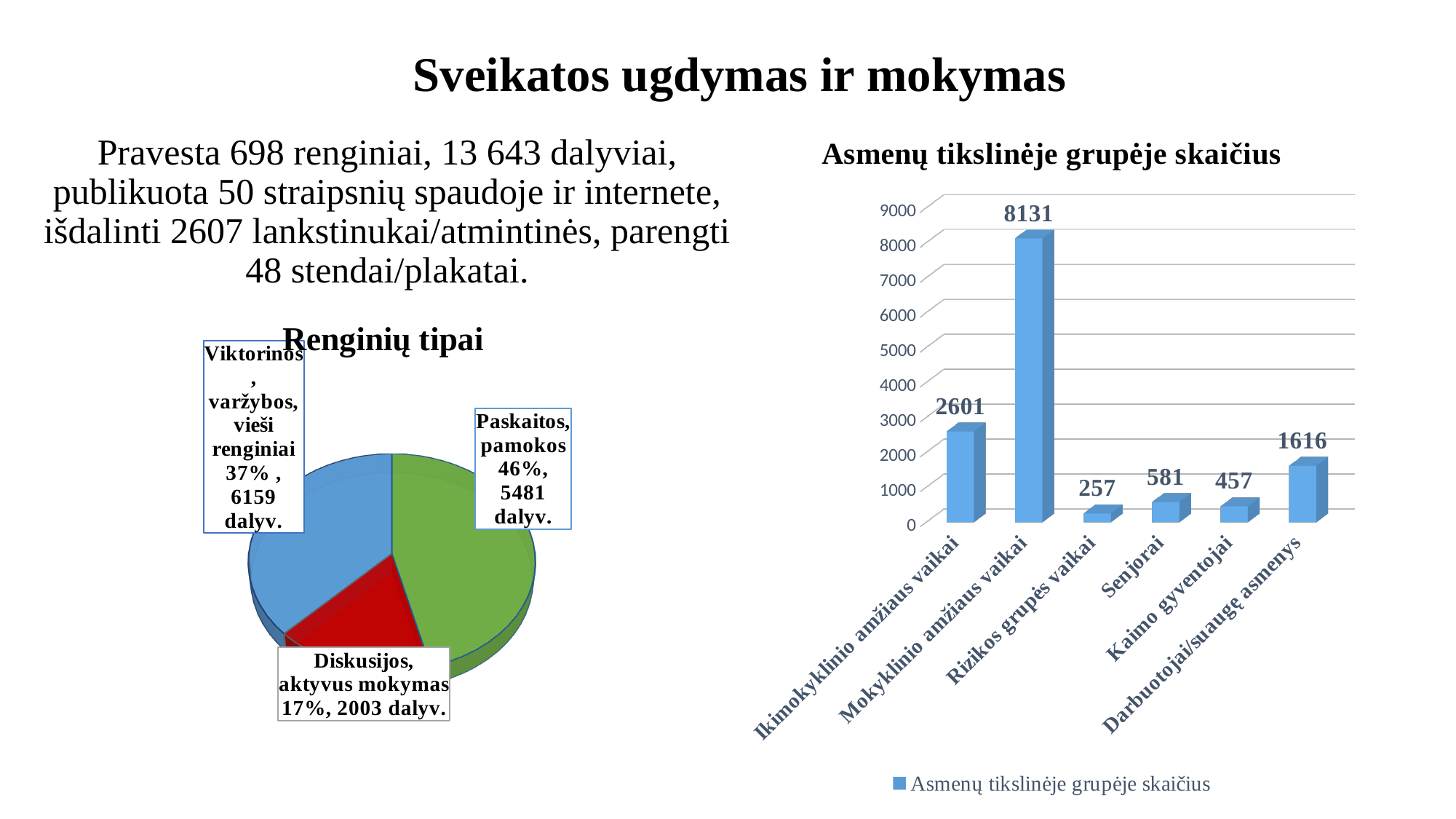
How many series does the legend of the 'Asmenų tikslinėje grupėje skaičius' chart list? 1 In the 'Asmenų tikslinėje grupėje skaičius' chart, what is the difference between Ikimokyklinio amžiaus vaikai and Darbuotojai/suaugę asmenys? 985 In the 'Asmenų tikslinėje grupėje skaičius' chart, what is the value for Senjorai? 581 In the 'Renginių tipai' pie chart, what share does Paskaitos, pamokos have? 46% In the 'Asmenų tikslinėje grupėje skaičius' chart, what is the value for Mokyklinio amžiaus vaikai? 8131 In the 'Asmenų tikslinėje grupėje skaičius' chart, which category has the lowest value? Rizikos grupės vaikai In the 'Renginių tipai' pie chart, how many participants (dalyv.) are shown for Diskusijos, aktyvus mokymas? 2003 In the 'Asmenų tikslinėje grupėje skaičius' chart, which is larger: Senjorai or Kaimo gyventojai? Senjorai What kind of chart is 'Asmenų tikslinėje grupėje skaičius'? Bar chart In the 'Renginių tipai' pie chart, which slice has the smallest share? Diskusijos, aktyvus mokymas In the 'Asmenų tikslinėje grupėje skaičius' chart, how many categories are shown? 6 In the 'Asmenų tikslinėje grupėje skaičius' chart, which category has the highest value? Mokyklinio amžiaus vaikai